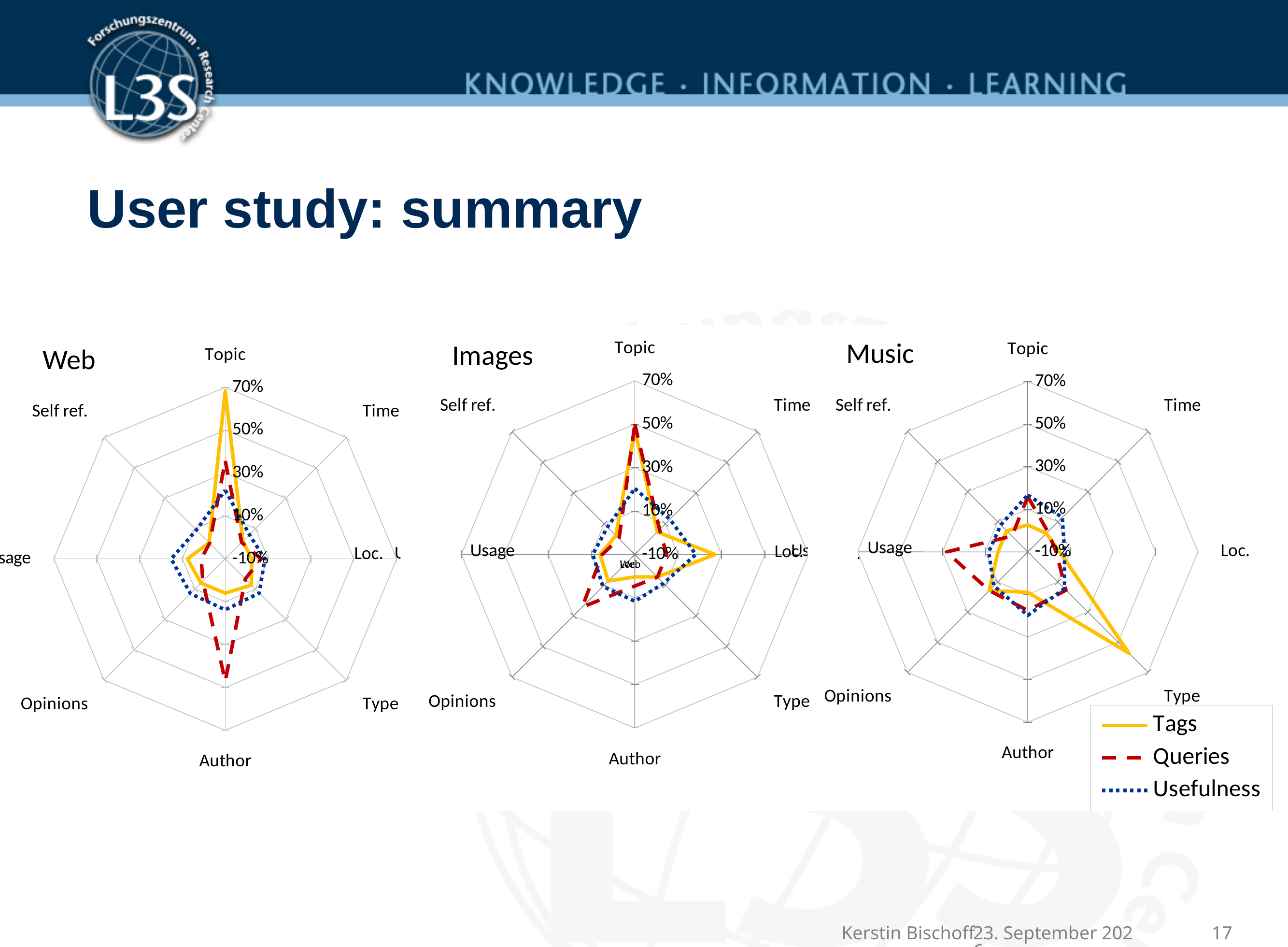
In the Images chart, is the Queries value for Topic greater or less than 30%? greater Which series is drawn with a dotted blue line in the legend? Usefulness In the Web chart, is the Tags value for Topic greater or less than 50%? greater How many categories (axes) does the Web radar chart have? 8 What kind of chart is used for the Web, Images and Music panels on this slide? Radar chart In the Web chart, which series has the larger value at Topic, Tags or Queries? Tags In the Web chart, is the Queries value for Author greater or less than 30%? greater In the Web chart, at which category does the Tags series reach its highest value? Topic In the Music chart, at which category does the Tags series reach its highest value? Type How many series does the legend list? 3